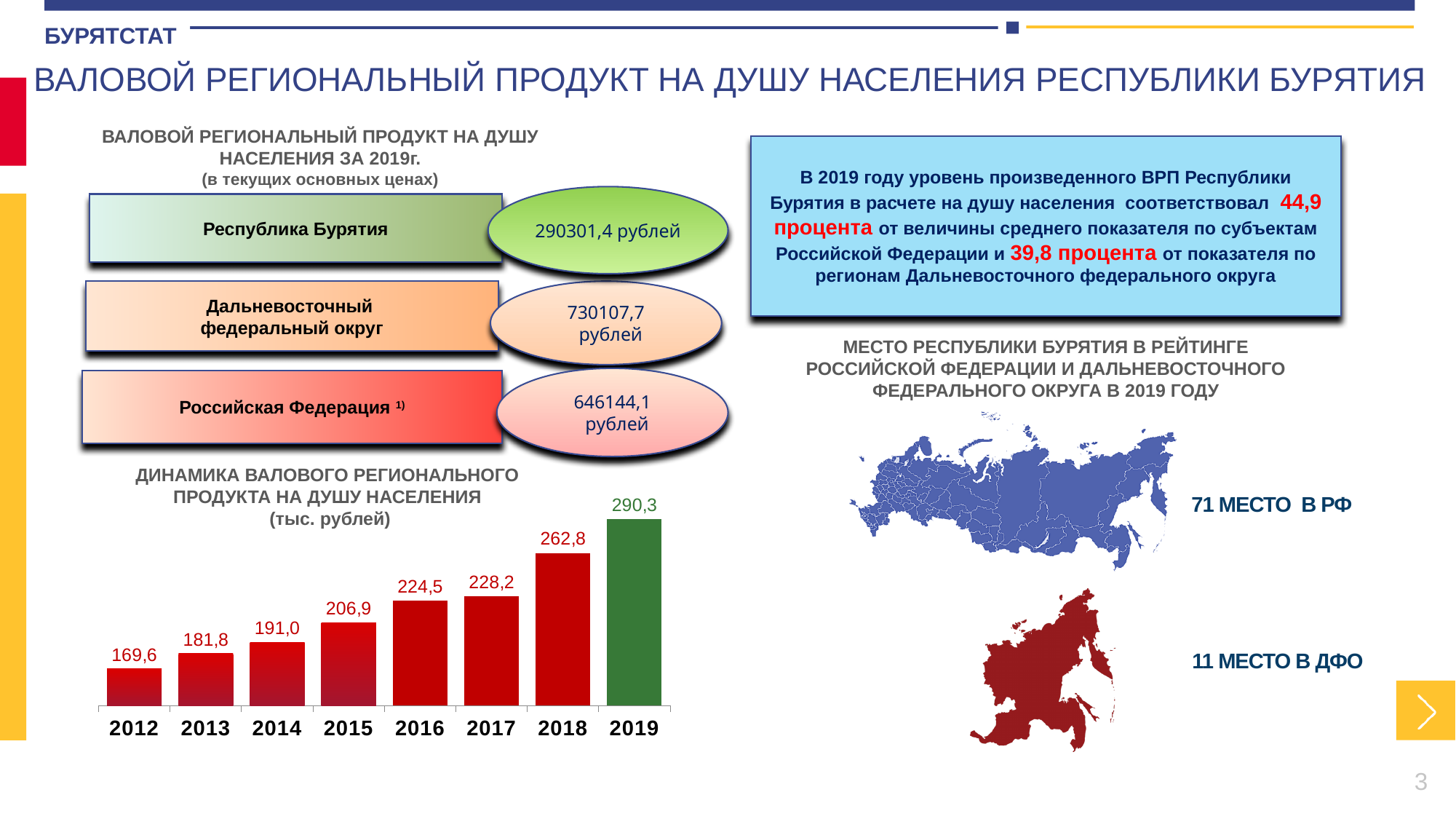
Which is larger in the bar chart, the value for 2015 or the value for 2014? 2015 What is the difference between the values for 2019 and 2018 in the bar chart? 27,5 What is the difference between the values for 2013 and 2012 in the bar chart? 12,2 What is the value for 2012 in the bar chart? 169,6 Which year has the highest value in the bar chart? 2019 What is the value for 2019 in the bar chart? 290,3 What is the value for 2016 in the bar chart? 224,5 What colour is the bar for 2019 in the bar chart? green Which year has the lowest value in the bar chart? 2012 Do the values in the bar chart rise or fall from 2012 to 2019? rise How many years are shown in the bar chart? 8 What kind of chart shows the dynamics of gross regional product per capita? bar chart